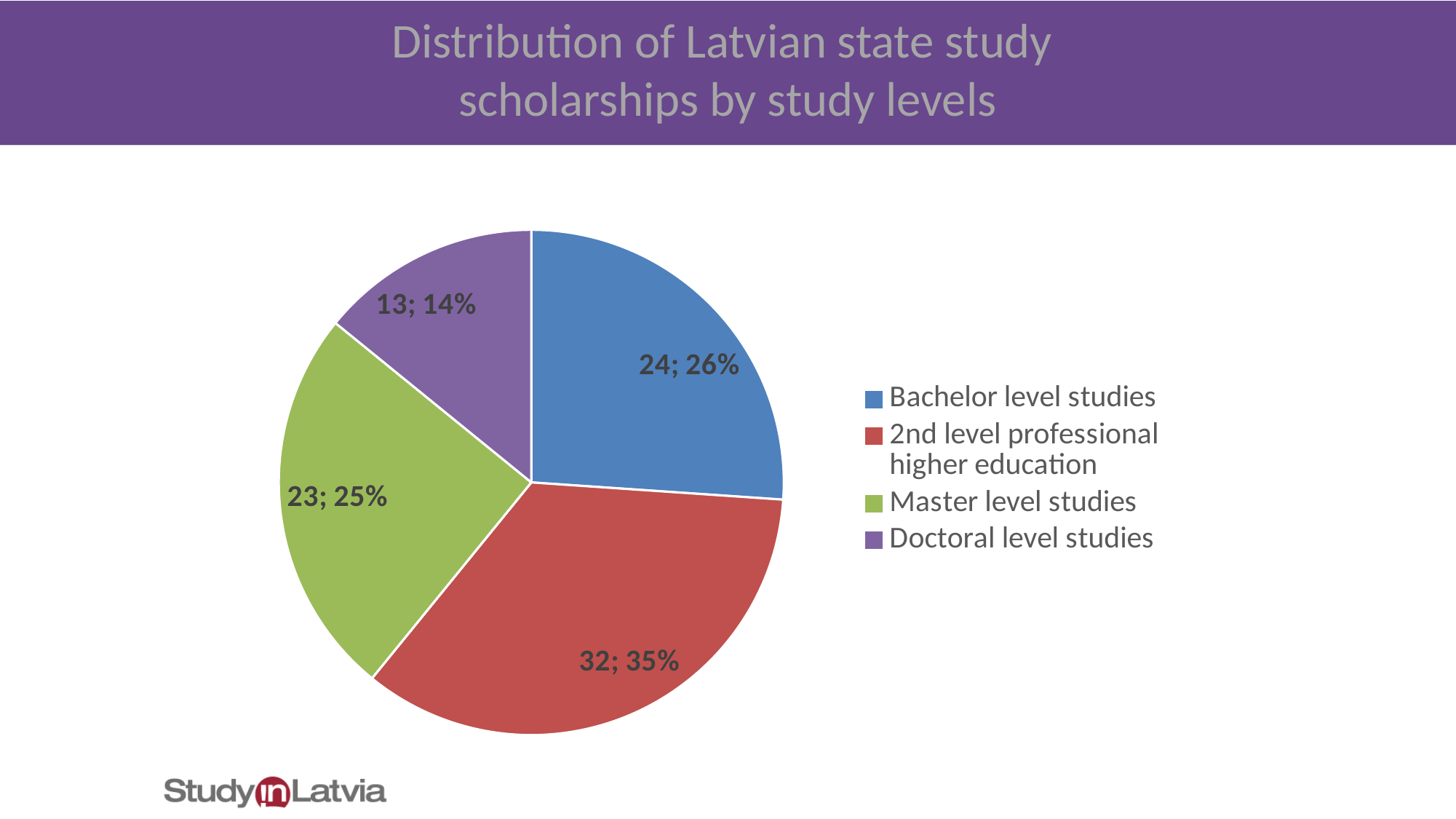
How many scholarships are shown for 2nd level professional higher education? 32 How many scholarships are shown for Doctoral level studies? 13 What kind of chart is shown on the slide? pie chart What is the difference between the number of scholarships for 2nd level professional higher education and Doctoral level studies? 19 How many scholarships are shown for Bachelor level studies? 24 How many scholarships are shown for Master level studies? 23 What share of the pie does Doctoral level studies take? 14% What share of the pie does 2nd level professional higher education take? 35% Which study level has the smallest slice? Doctoral level studies Which study level has the largest slice? 2nd level professional higher education Which has more scholarships, Bachelor level studies or Master level studies? Bachelor level studies How many categories does the legend list? 4